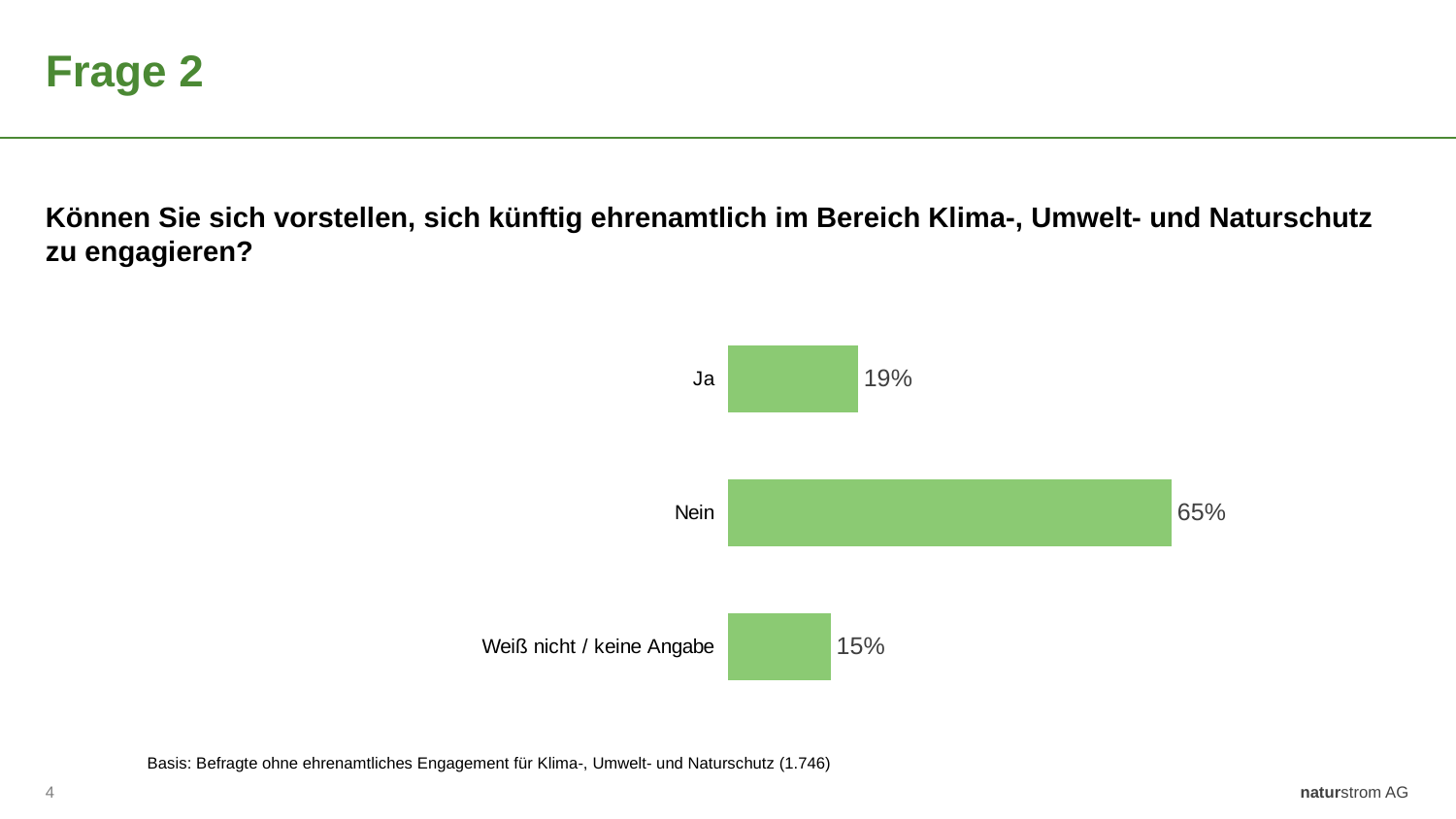
What percentage of respondents answered "Weiß nicht / keine Angabe"? 15% What is the difference in percentage points between "Ja" and "Weiß nicht / keine Angabe"? 4 What is the total of the three percentages shown in the chart? 99% What is the difference in percentage points between "Nein" and "Ja"? 46 How many answer categories are shown in the chart? 3 What kind of chart is shown on the slide? Bar chart Which answer category has the highest percentage? Nein Which answer category has the lowest percentage? Weiß nicht / keine Angabe What percentage of respondents answered "Nein"? 65% What percentage of respondents answered "Ja"? 19% What colour are the bars in the chart? Green Which is larger, the value for "Ja" or the value for "Nein"? Nein